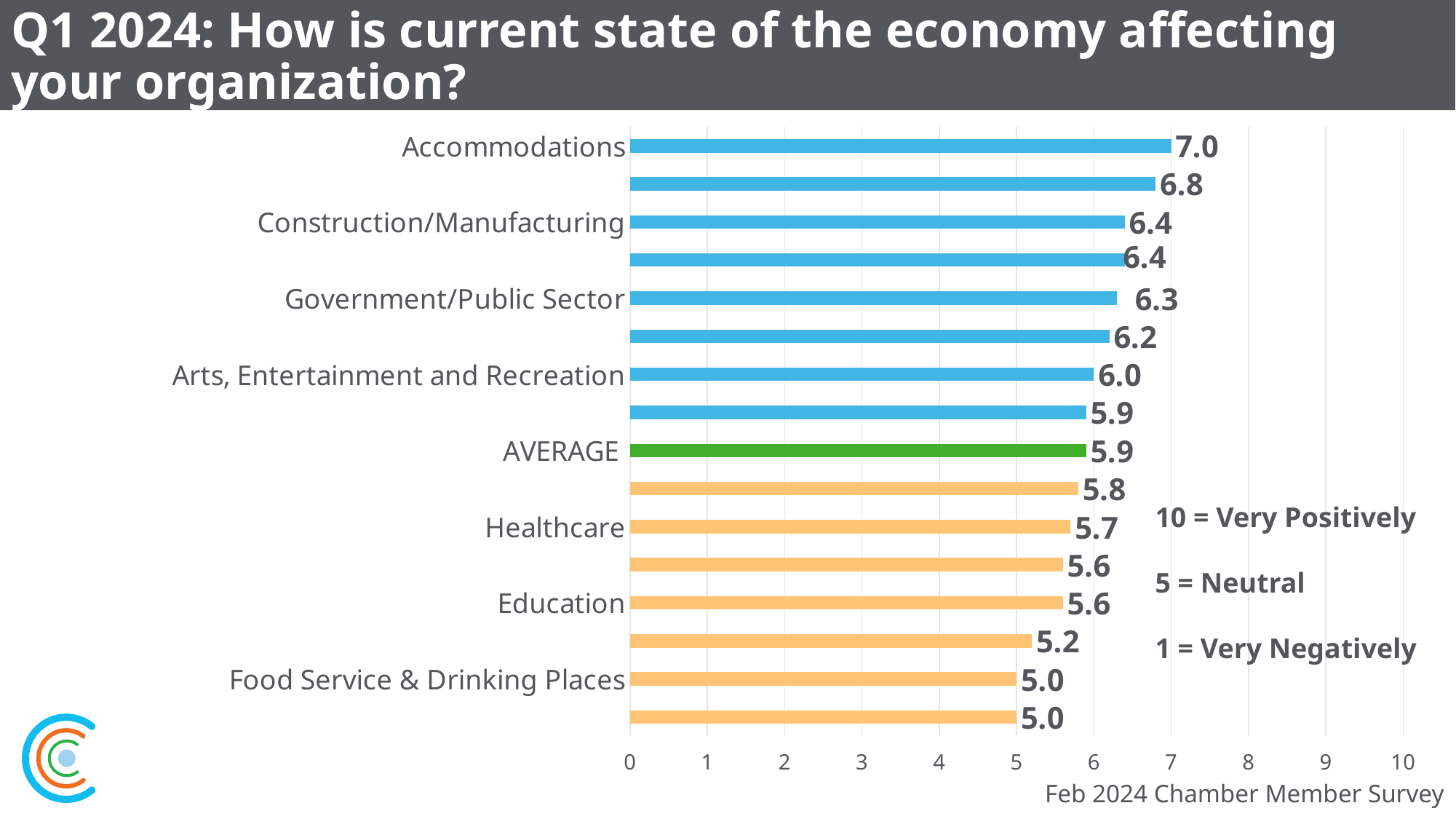
What is the lowest value shown on the chart? 5.0 What is the AVERAGE value shown on the chart? 5.9 What is the value for Accommodations? 7.0 Is the value for Arts, Entertainment and Recreation greater or less than 5? greater Which is larger, the value for Construction/Manufacturing or the value for Education? Construction/Manufacturing How many bars are plotted on the chart? 16 What is the value for Government/Public Sector? 6.3 What is the value for Food Service & Drinking Places? 5.0 What is the value for Healthcare? 5.7 Which labeled category has the highest value? Accommodations What kind of chart is shown on the slide? bar chart What is the difference between the values for Accommodations and Healthcare? 1.3